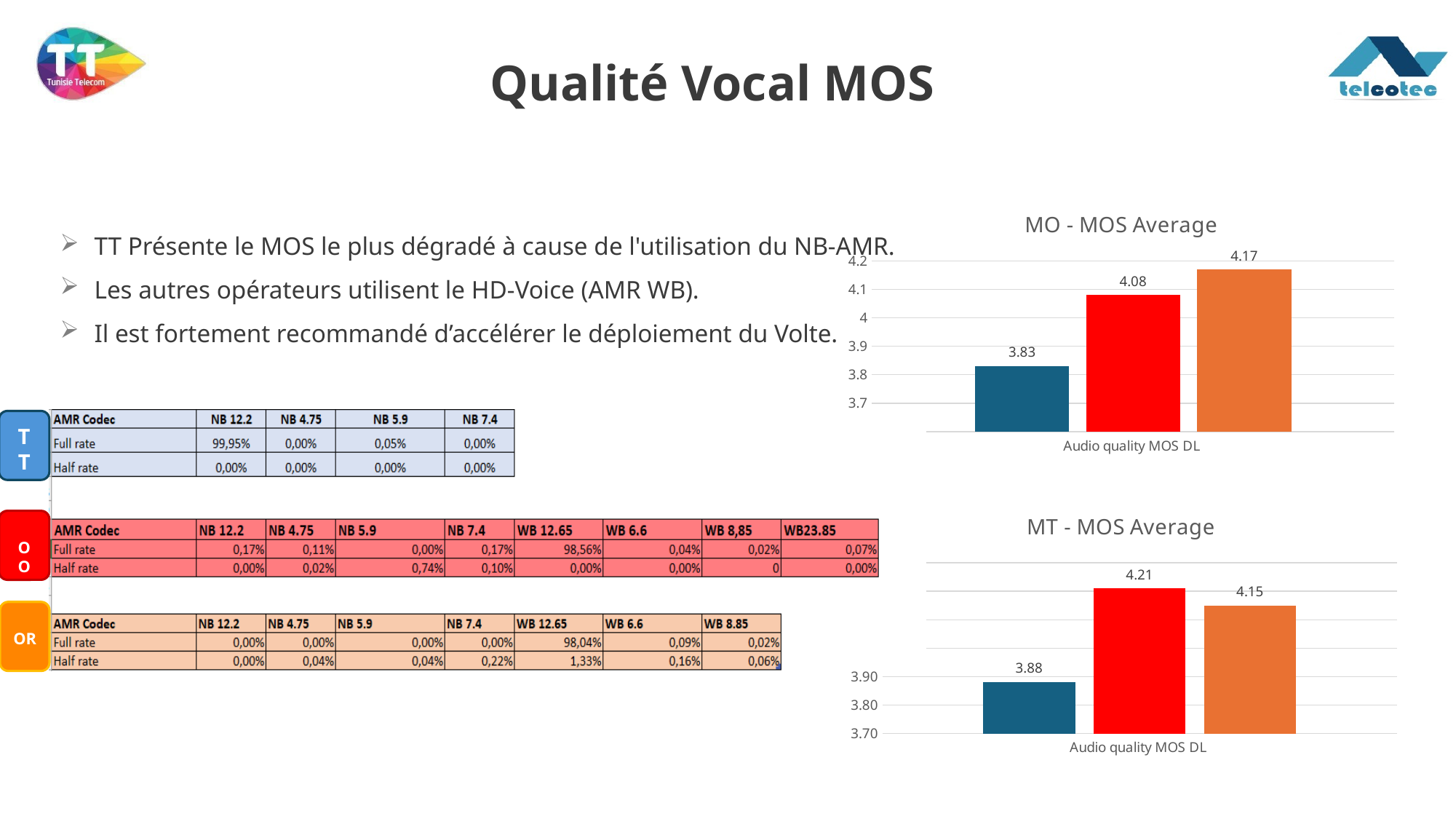
In the MO - MOS Average chart, what is the value of the orange (third) bar? 4.17 In the MT - MOS Average chart, what is the difference between the red bar and the orange bar? 0.06 In the MO - MOS Average chart, what is the difference between the orange bar and the blue bar? 0.34 In the MT - MOS Average chart, which bar has the lowest value? The blue (first) bar, 3.88 What type of chart is the MO - MOS Average chart? Bar chart In the MO - MOS Average chart, is the value of the red bar greater or less than 4? greater In the MO - MOS Average chart, what is the value of the blue (first) bar? 3.83 In the MO - MOS Average chart, which bar has the highest value? The orange (third) bar, 4.17 In the MT - MOS Average chart, what is the value of the red (second) bar? 4.21 In the MT - MOS Average chart, what is the value of the blue (first) bar? 3.88 In the MT - MOS Average chart, which is larger, the red bar or the orange bar? The red bar (4.21) How many bars are plotted in the MT - MOS Average chart? 3